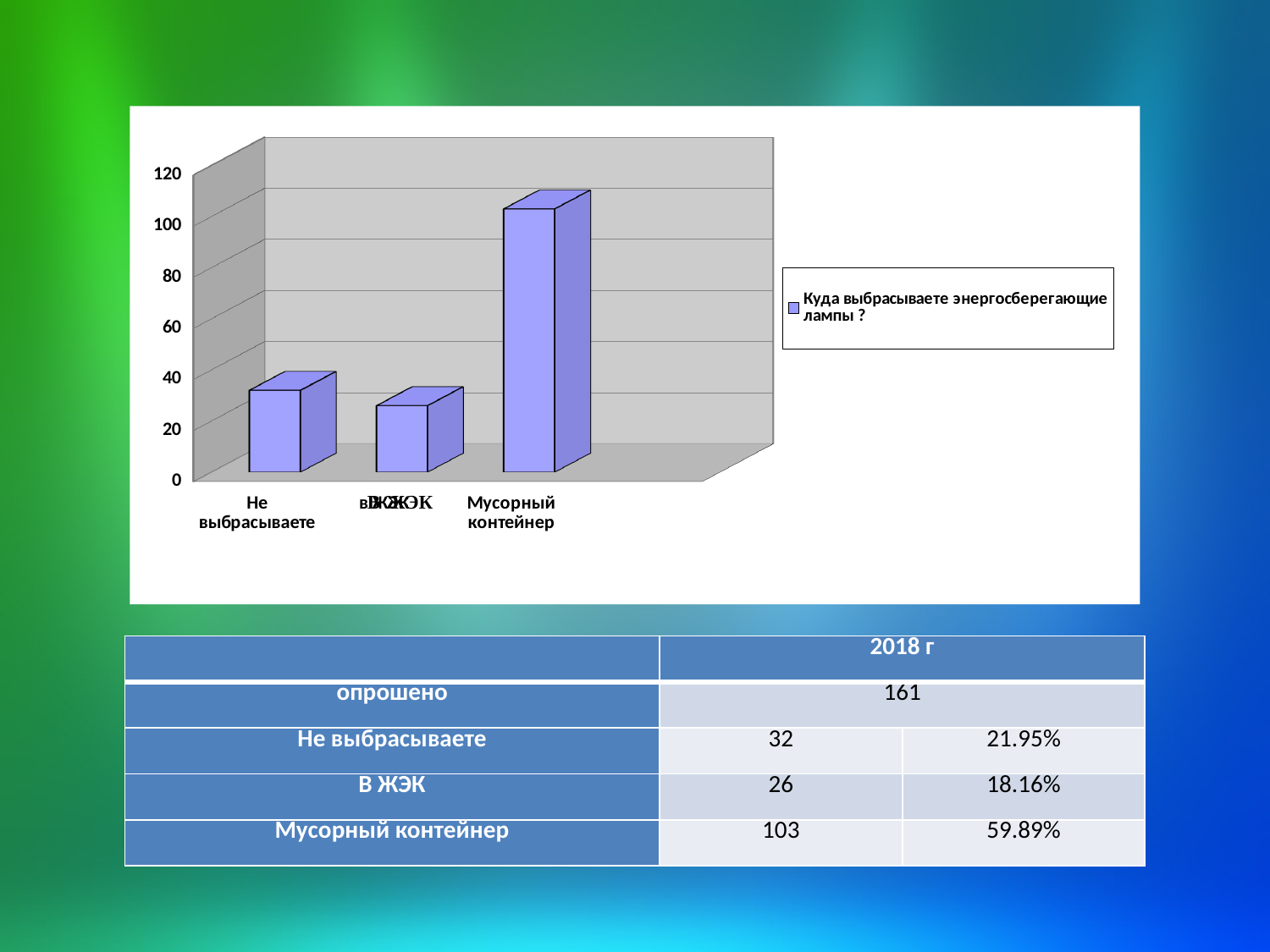
How many categories are plotted in the bar chart? 3 What is the value for Мусорный контейнер? 103 What is the value for Не выбрасываете? 32 Which is larger, the value for Не выбрасываете or the value for В ЖЭК? Не выбрасываете Which category has the highest bar in the chart? Мусорный контейнер How many series does the chart legend list? 1 What is the text of the legend entry in the chart? Куда выбрасываете энергосберегающие лампы ? Which category has the lowest bar in the chart? В ЖЭК Is the value for Мусорный контейнер greater or less than 80? greater Is the value for Не выбрасываете greater or less than 40? less What is the difference between the values for Мусорный контейнер and Не выбрасываете? 71 What kind of chart is shown on the slide? bar chart